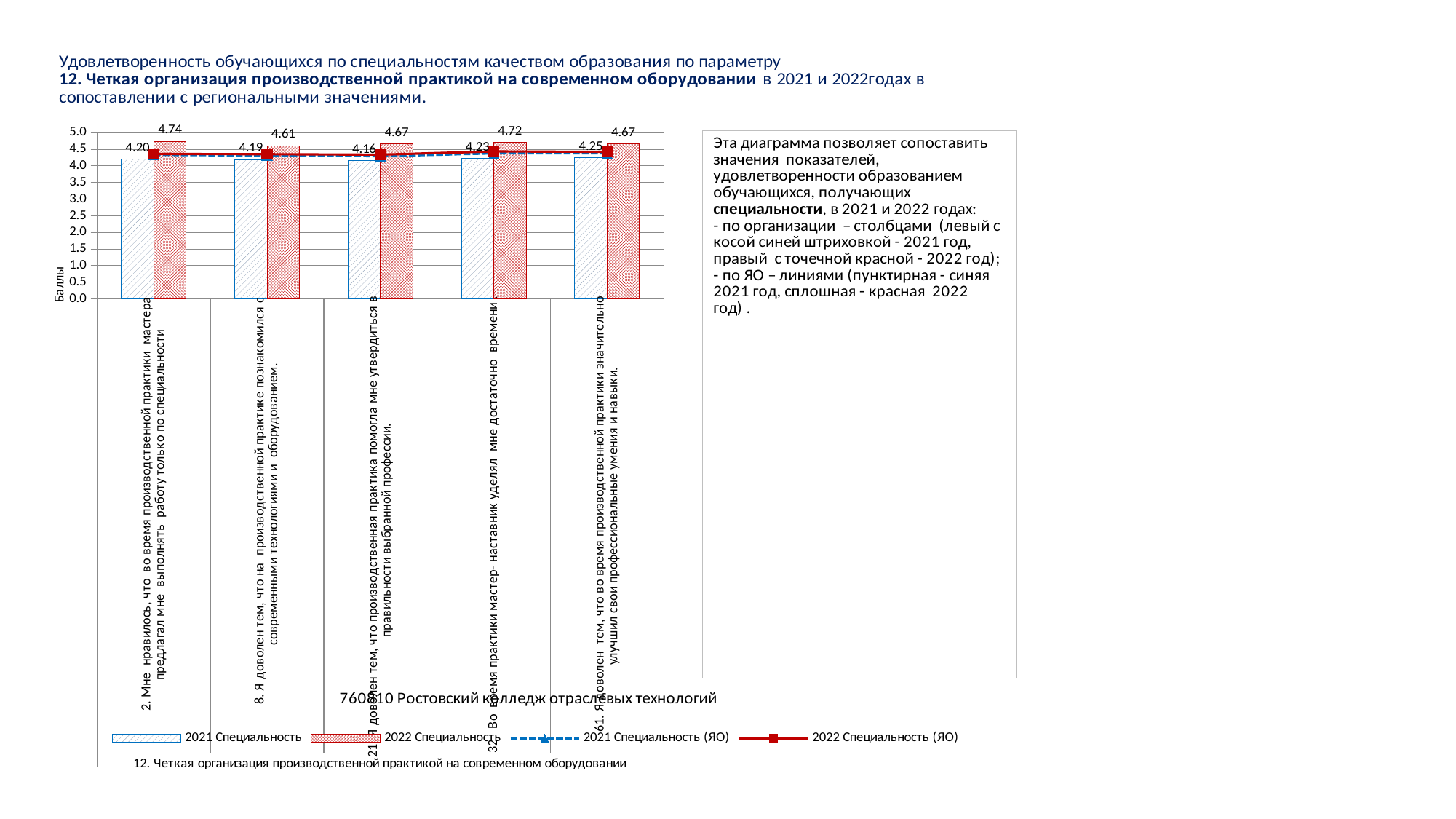
Which category has the highest 2022 Специальность value? 2. Мне нравилось, что во время производственной практики мастер предлагал мне выполнять работу только по специальности (4.74) Which category has the lowest 2021 Специальность value? 21. Я доволен тем, что производственная практика помогла мне утвердиться в правильности выбранной профессии (4.16) What is the title of the vertical axis of the chart? Баллы What is the value of the 2022 Специальность bar for the category "8. Я доволен тем, что на производственной практике познакомился с современными технологиями и оборудованием"? 4.61 What is the value of the 2021 Специальность bar for the category "2. Мне нравилось, что во время производственной практики мастер предлагал мне выполнять работу только по специальности"? 4.20 How many categories are shown on the x axis of the chart? 5 How many series does the chart legend list? 4 What is the difference between the 2022 Специальность and 2021 Специальность values for the category "2. Мне нравилось, что во время производственной практики мастер предлагал мне выполнять работу только по специальности"? 0.54 What is the difference between the 2022 Специальность and 2021 Специальность values for the category "32. Во время практики мастер-наставник уделял мне достаточно времени"? 0.49 What is the value of the 2021 Специальность bar for the category "61. Я доволен тем, что во время производственной практики значительно улучшил свои профессиональные умения и навыки"? 4.25 Which has the larger 2022 Специальность value: category 32 (мастер-наставник уделял мне достаточно времени) or category 61 (значительно улучшил свои профессиональные умения и навыки)? Category 32 (4.72) Is the value of the 2021 Специальность (ЯО) line for the first category greater or less than 4.0? greater